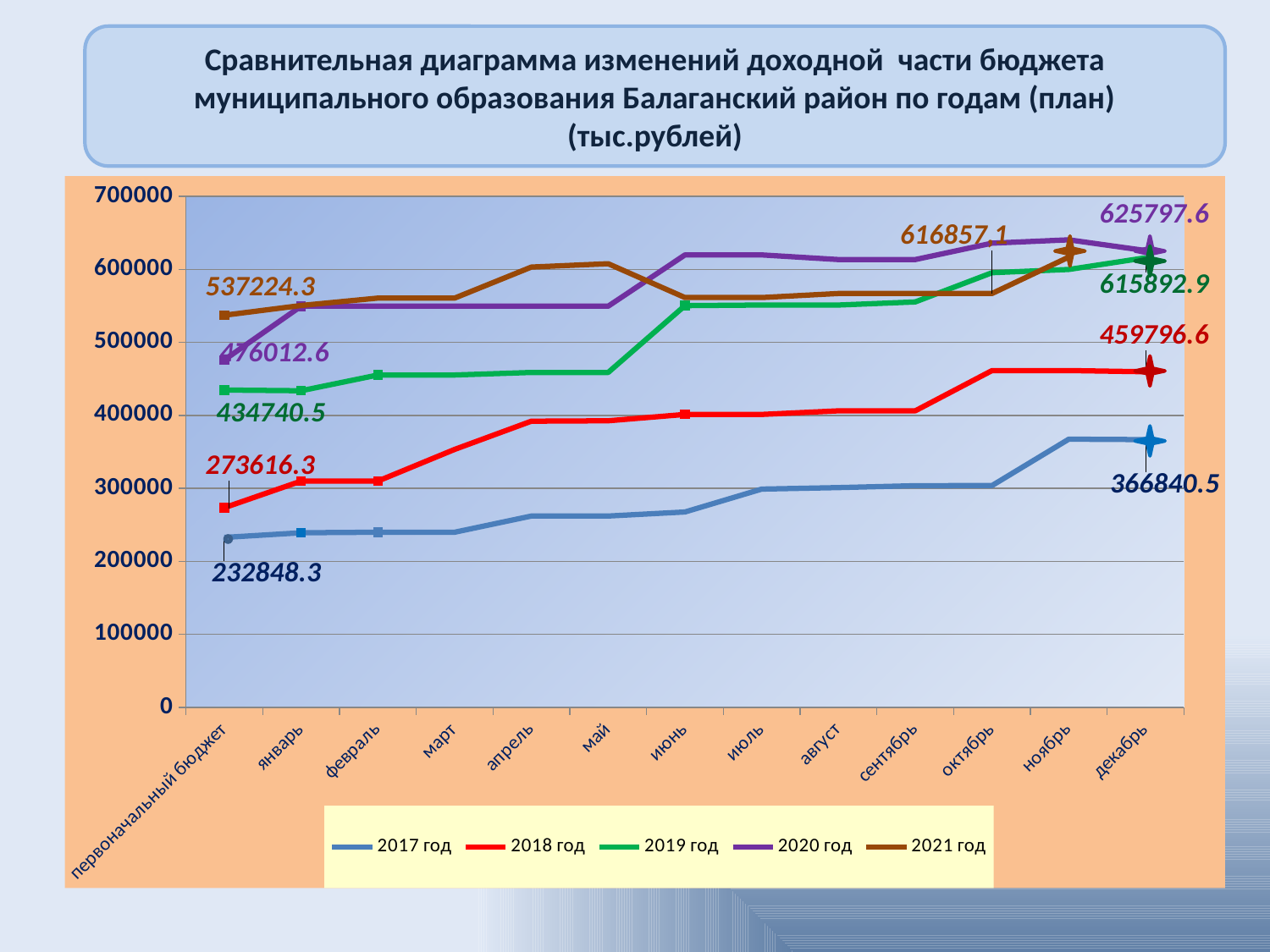
What is the value for 2018 год at декабрь? 459796.6 What is the value for 2017 год at первоначальный бюджет? 232848.3 What type of chart is shown on the slide? line chart How many categories are shown along the x axis? 13 What is the value for 2019 год at первоначальный бюджет? 434740.5 Which series has the highest value at первоначальный бюджет? 2021 год What is the value for 2020 год at декабрь? 625797.6 How many series does the legend list? 5 Which series has the lowest value at декабрь? 2017 год What is the difference between the 2018 год values at декабрь and первоначальный бюджет? 186180.3 Is the value for 2017 год at июль greater or less than 400000? less What is the value for 2021 год at ноябрь? 616857.1